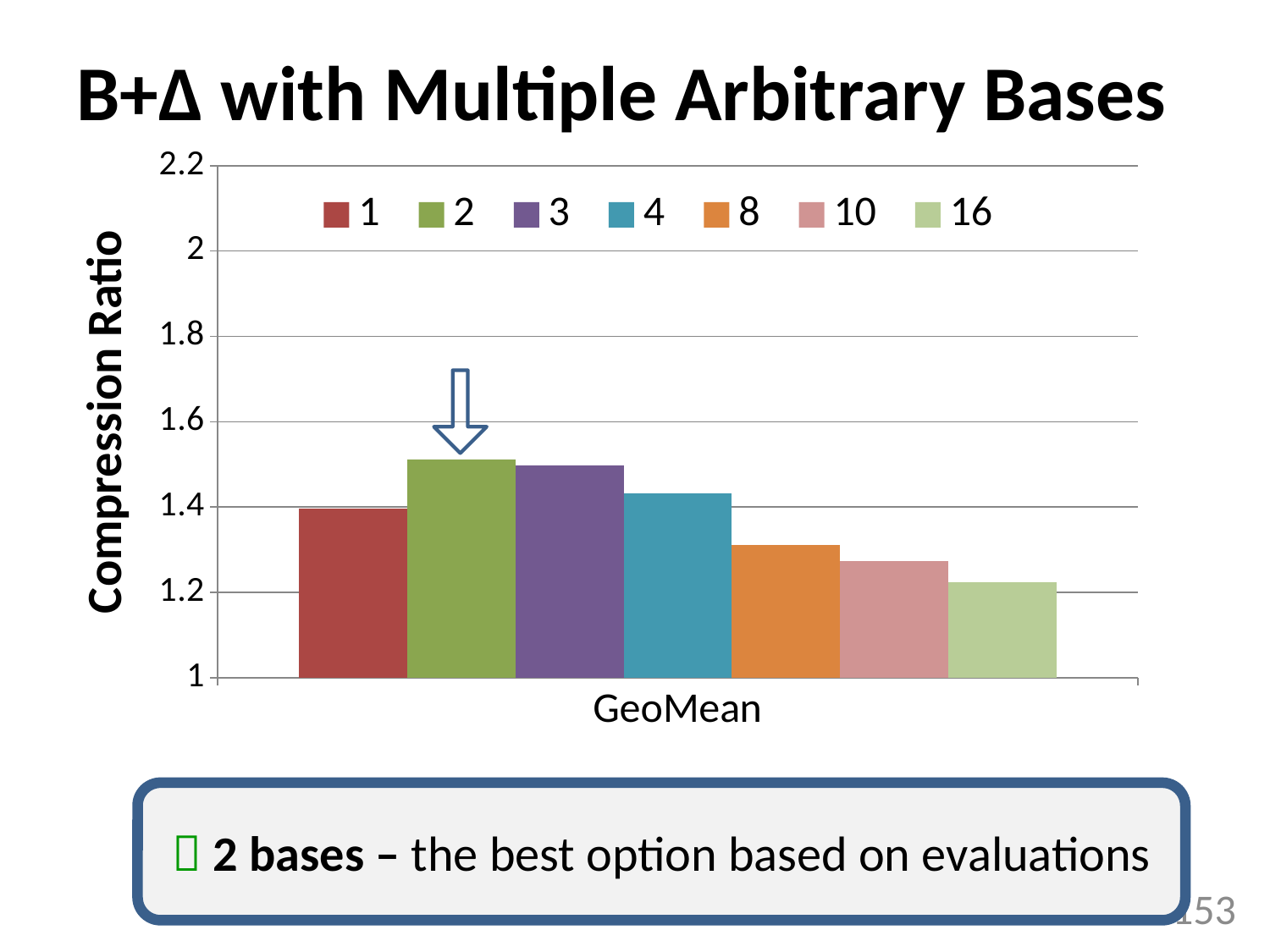
How many series does the chart legend list? 7 Is the compression ratio for series 2 greater or less than 1.6? less What kind of chart is shown on the slide? bar chart Is the compression ratio for series 10 greater or less than 1.2? greater Which has the larger compression ratio, series 2 or series 8? 2 What is the label of the category on the x axis? GeoMean Is the compression ratio for series 8 greater or less than 1.4? less Which series has the lowest compression ratio for GeoMean? 16 Which has the larger compression ratio, series 4 or series 16? 4 What is the label of the y axis of the chart? Compression Ratio How many categories are shown on the x axis of the chart? 1